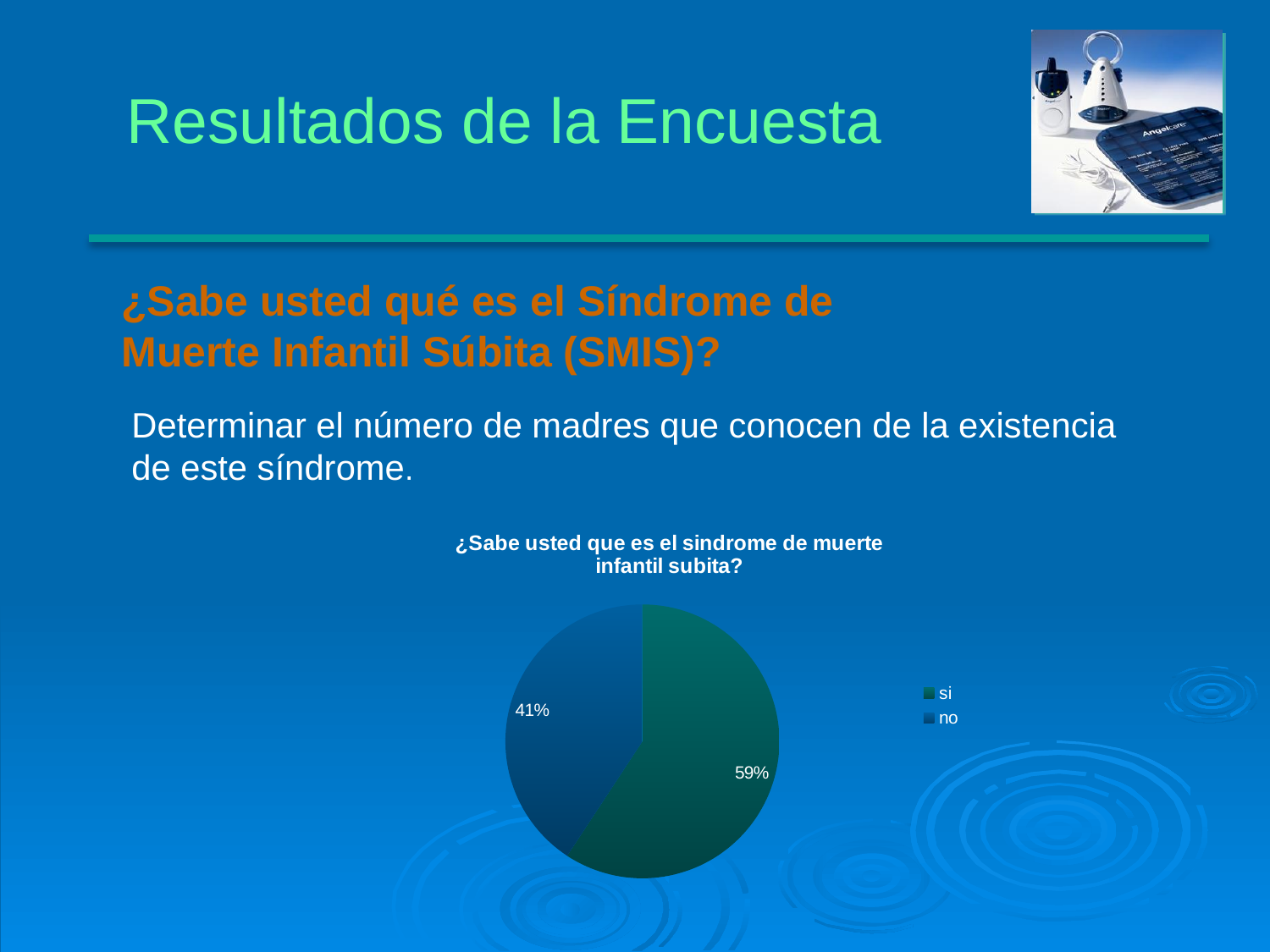
What is the difference in percentage points between the "si" and "no" slices? 18 What percentage of the pie corresponds to "no"? 41% What are the two legend entries of the pie chart? si, no How many entries does the legend list? 2 How many slices does the pie chart have? 2 What kind of chart is shown on the slide? pie chart What is the chart's title? ¿Sabe usted que es el sindrome de muerte infantil subita? Which is larger, the "si" slice or the "no" slice? si What percentage of the pie corresponds to "si"? 59% Which slice is the smallest in the pie chart? no What share of the pie does the "no" slice represent? 41% Which slice is the largest in the pie chart? si